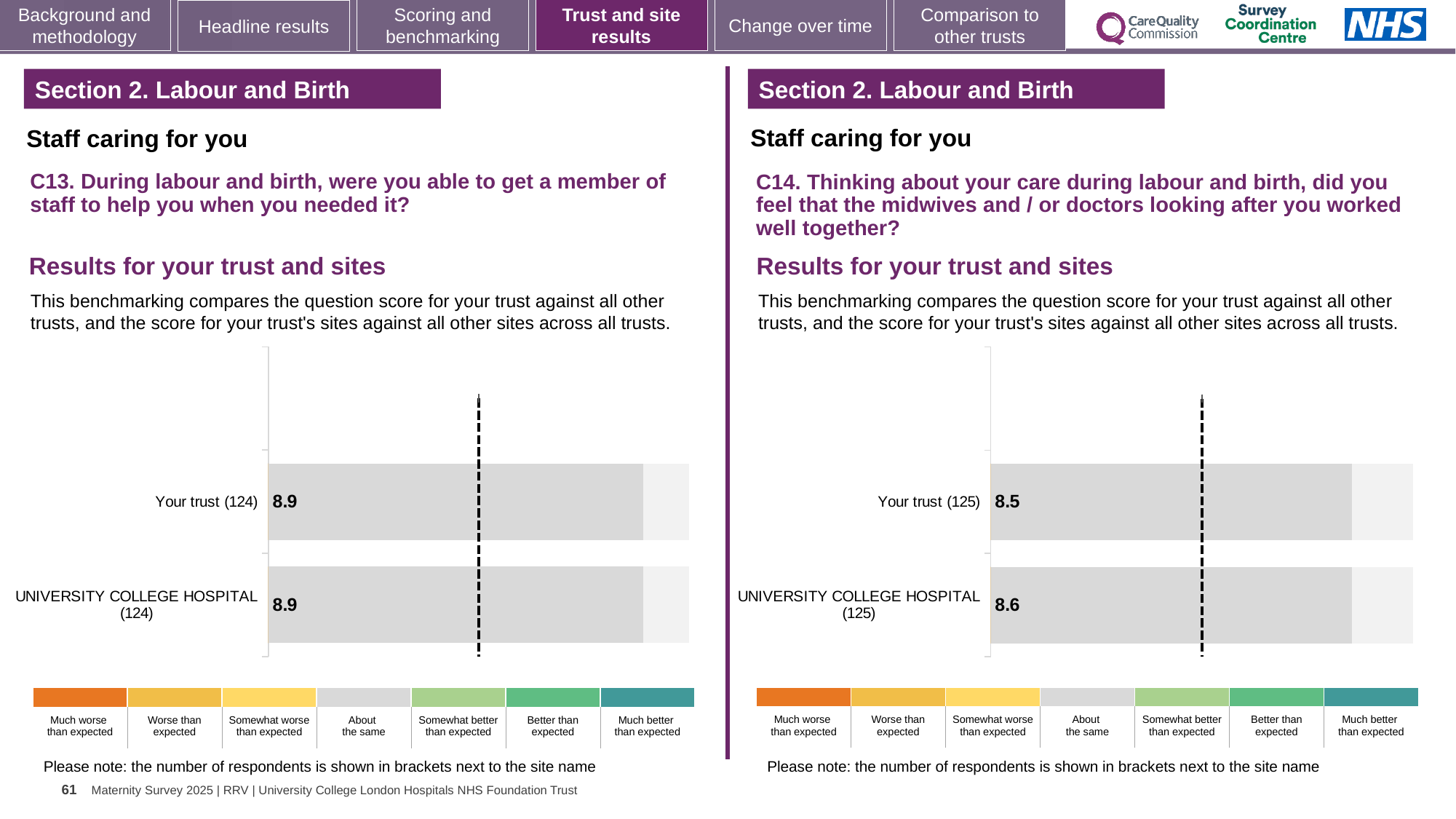
How many bars are plotted in the C14 chart on the right? 2 In the C14 chart on the right, what is the difference between the UNIVERSITY COLLEGE HOSPITAL score and the Your trust score? 0.1 In the C14 chart on the right, which has the higher score, Your trust or UNIVERSITY COLLEGE HOSPITAL? UNIVERSITY COLLEGE HOSPITAL In the C13 chart on the left, what is the score for Your trust (124)? 8.9 In the C14 chart on the right, what is the score for UNIVERSITY COLLEGE HOSPITAL (125)? 8.6 How many bars are plotted in the C13 chart on the left? 2 What type of chart is used for the C13 results on the left? Bar chart How many categories does the colour legend below the C13 chart on the left list? 7 How many respondents are shown in brackets for Your trust in the C14 chart on the right? 125 In the C13 chart on the left, what is the score for UNIVERSITY COLLEGE HOSPITAL (124)? 8.9 In the C13 chart on the left, what is the difference between the Your trust score and the UNIVERSITY COLLEGE HOSPITAL score? 0 In the C14 chart on the right, what is the score for Your trust (125)? 8.5